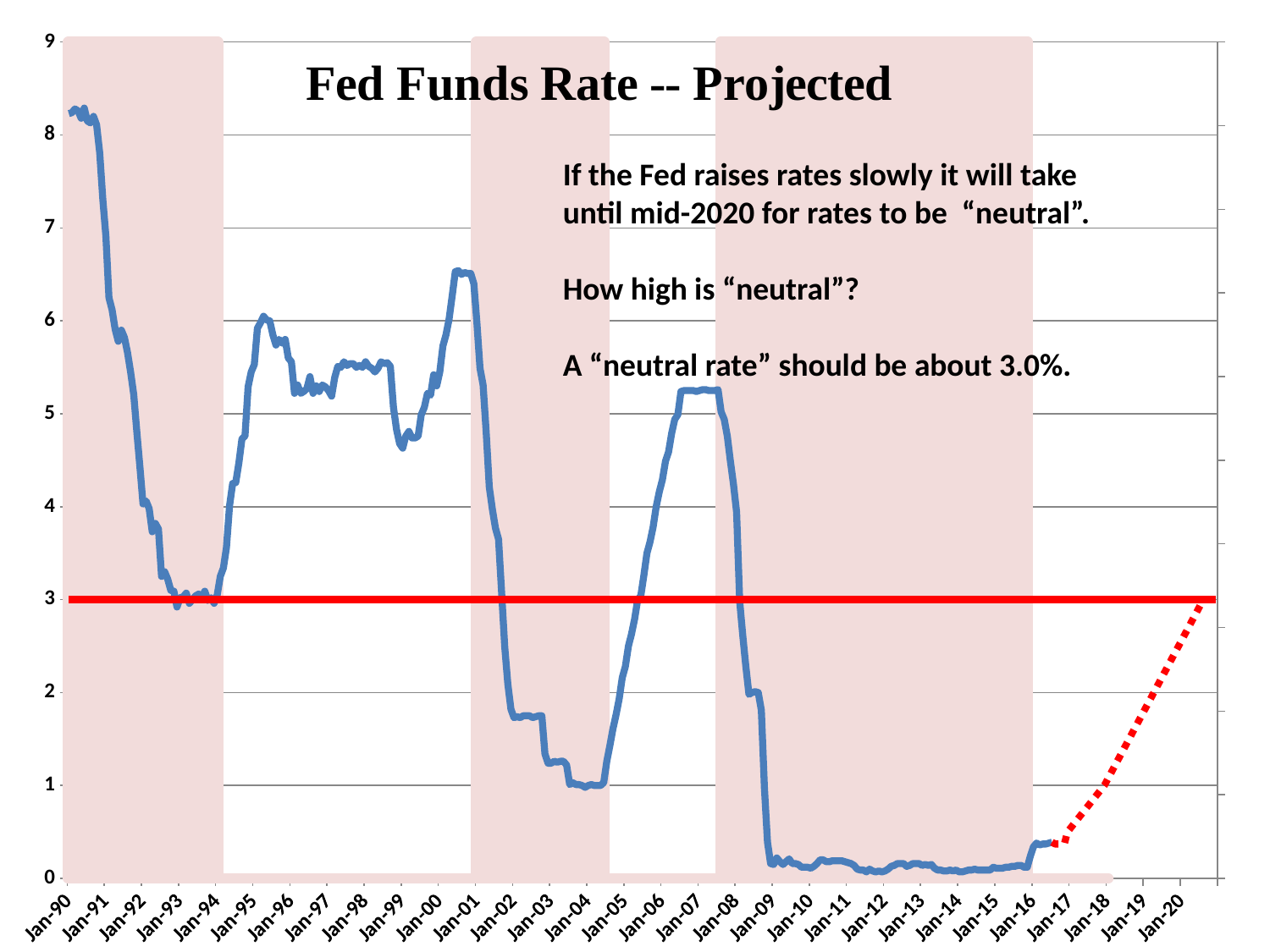
Is the value of the Fed Funds Rate at Jan-16 greater or less than 1? less At what level on the y axis is the solid red horizontal line drawn? 3 Does the Fed Funds Rate rise or fall between Jan-90 and Jan-93? fall Is the value of the Fed Funds Rate at Jan-10 greater or less than 1? less What is the title of the chart? Fed Funds Rate -- Projected Is the value of the Fed Funds Rate at Jan-90 greater or less than 8? greater Does the Fed Funds Rate rise or fall between Jan-04 and Jan-07? rise What kind of chart is shown on the slide? line chart Near which x-axis label does the Fed Funds Rate line reach its highest value? Jan-90 Which is higher, the Fed Funds Rate at Jan-01 or at Jan-07? Jan-01